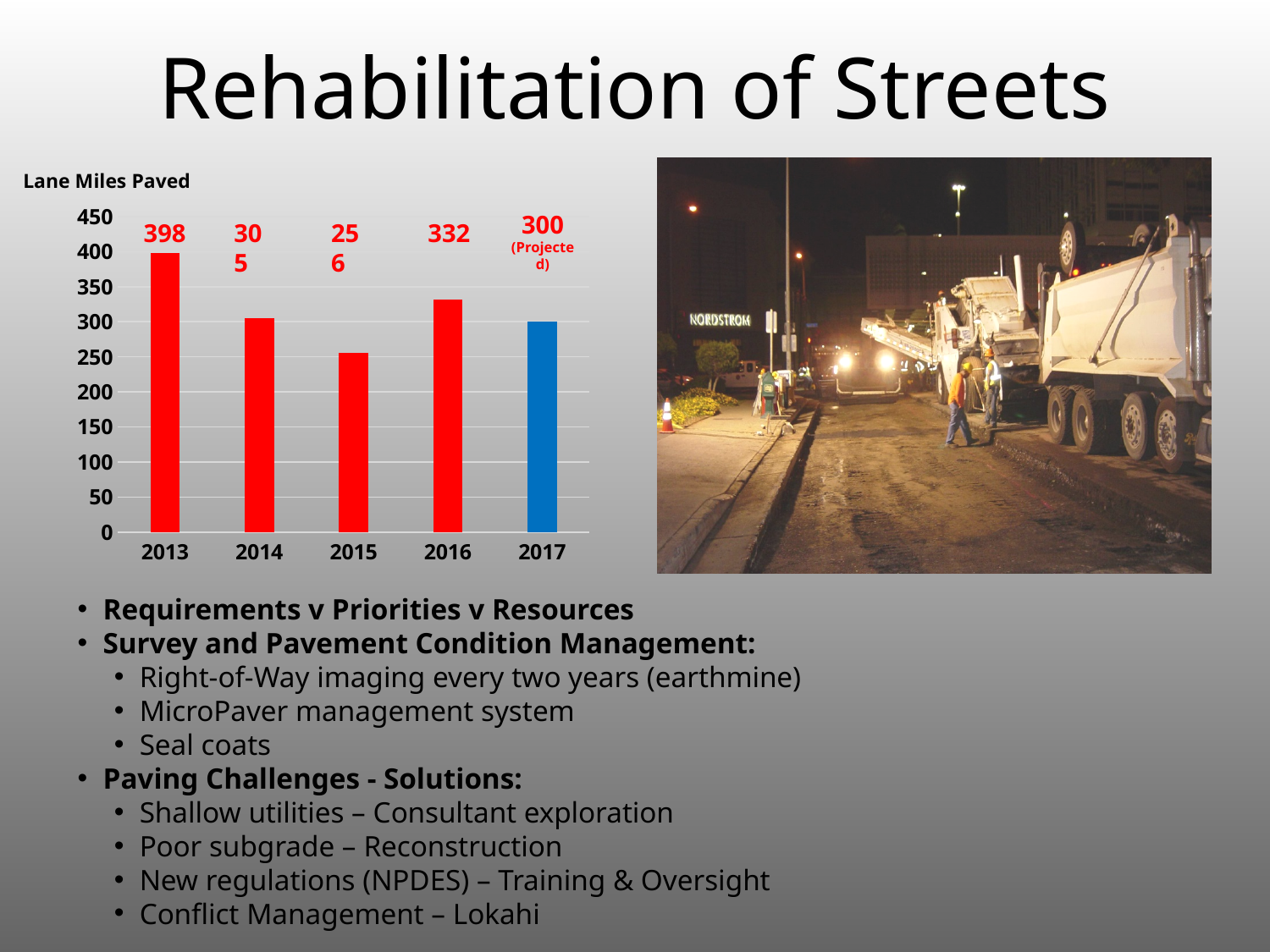
What is the difference between the 2013 and 2016 values in the Lane Miles Paved chart? 66 How many years are shown in the Lane Miles Paved chart? 5 Which is larger in the Lane Miles Paved chart, the value for 2014 or the value for 2016? 2016 Is the value for 2015 in the Lane Miles Paved chart greater or less than 300? less What is the value for 2013 in the Lane Miles Paved chart? 398 Which year has the lowest value in the Lane Miles Paved chart? 2015 What is the value for 2016 in the Lane Miles Paved chart? 332 What is the projected value for 2017 in the Lane Miles Paved chart? 300 What kind of chart is the Lane Miles Paved chart? bar chart Which year's bar in the Lane Miles Paved chart is coloured blue instead of red? 2017 What is the title of the chart on the slide? Lane Miles Paved Which year has the highest value in the Lane Miles Paved chart? 2013